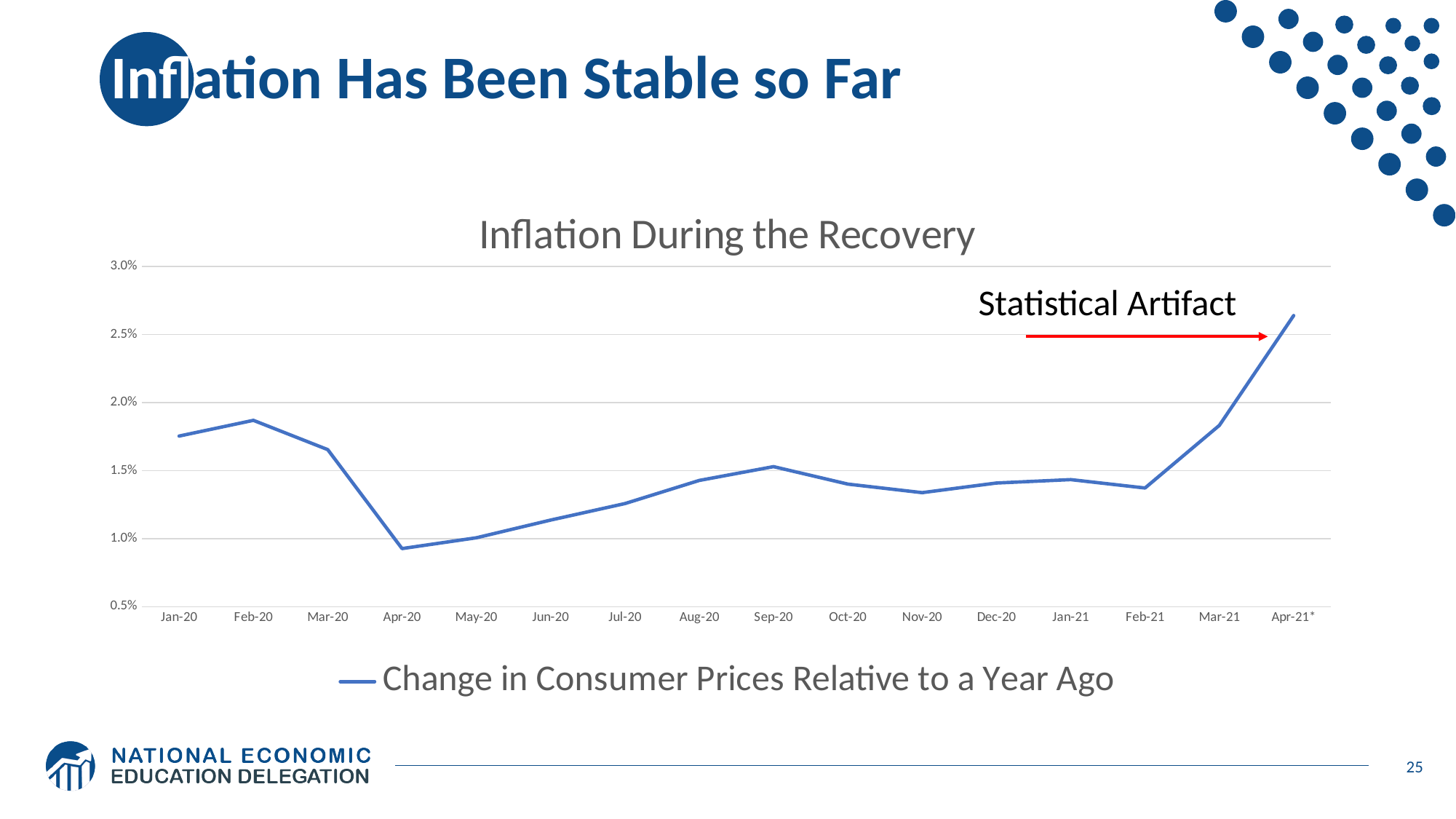
What is the title of the chart? Inflation During the Recovery Which month has the lowest value on the chart? Apr-20 How many series does the legend list? 1 Does the line rise or fall from Feb-21 to Apr-21*? Rises Which month has the highest value on the chart? Apr-21* What text does the red arrow on the chart point to the Apr-21* value with? Statistical Artifact Which is higher, the value for Feb-20 or the value for Mar-20? Feb-20 How many months are plotted along the x axis? 16 Is the value for Apr-20 greater or less than 1.0%? less Is the value for Mar-21 greater or less than 2.0%? less What kind of chart is shown on the slide? Line chart Is the value for Apr-21* greater or less than 2.5%? greater